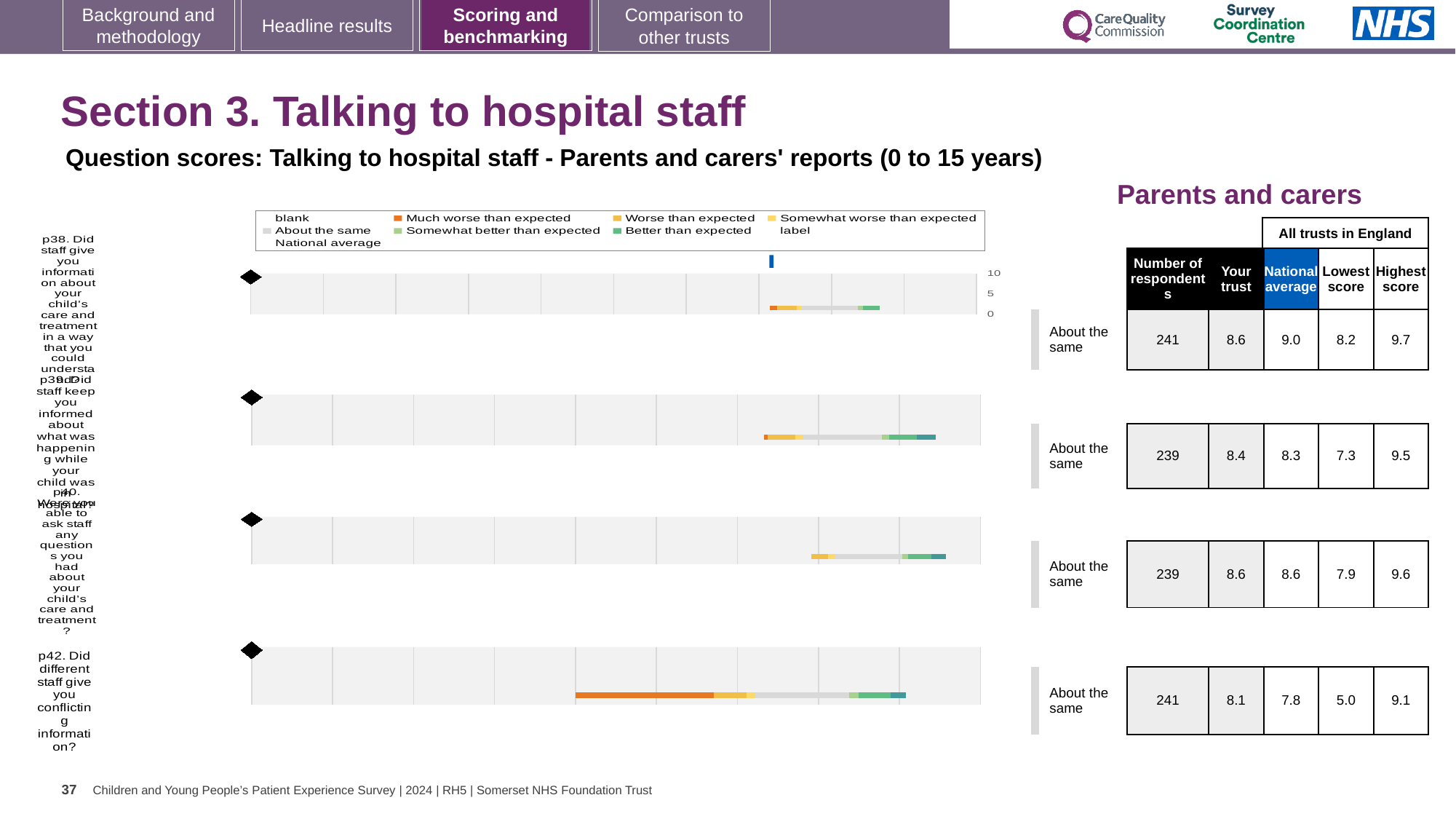
Which legend entry is shown in orange? Much worse than expected In the table beside the charts, what is the 'Your trust' score for p38 (staff giving information about your child's care and treatment in a way you could understand)? 8.6 In the table beside the charts, is the 'Your trust' score for p39 larger or smaller than the national average for p39? larger In the table beside the charts, what is the national average for p42 (different staff giving conflicting information)? 7.8 In the table beside the charts, what is the difference between the national average and 'Your trust' score for p38? 0.4 How many question charts (p38, p39, p40, p42) are plotted on the slide? 4 How many entries does the chart legend list? 9 In the table beside the charts, which question has the lowest 'Your trust' score? p42 In the table beside the charts, which question has the highest 'Highest score' value? p38 What benchmark category is shown next to each of the four charts? About the same In the table beside the charts, what is the lowest score among all trusts in England for p42? 5.0 What kind of chart is used to show the question scores on this slide? bar chart